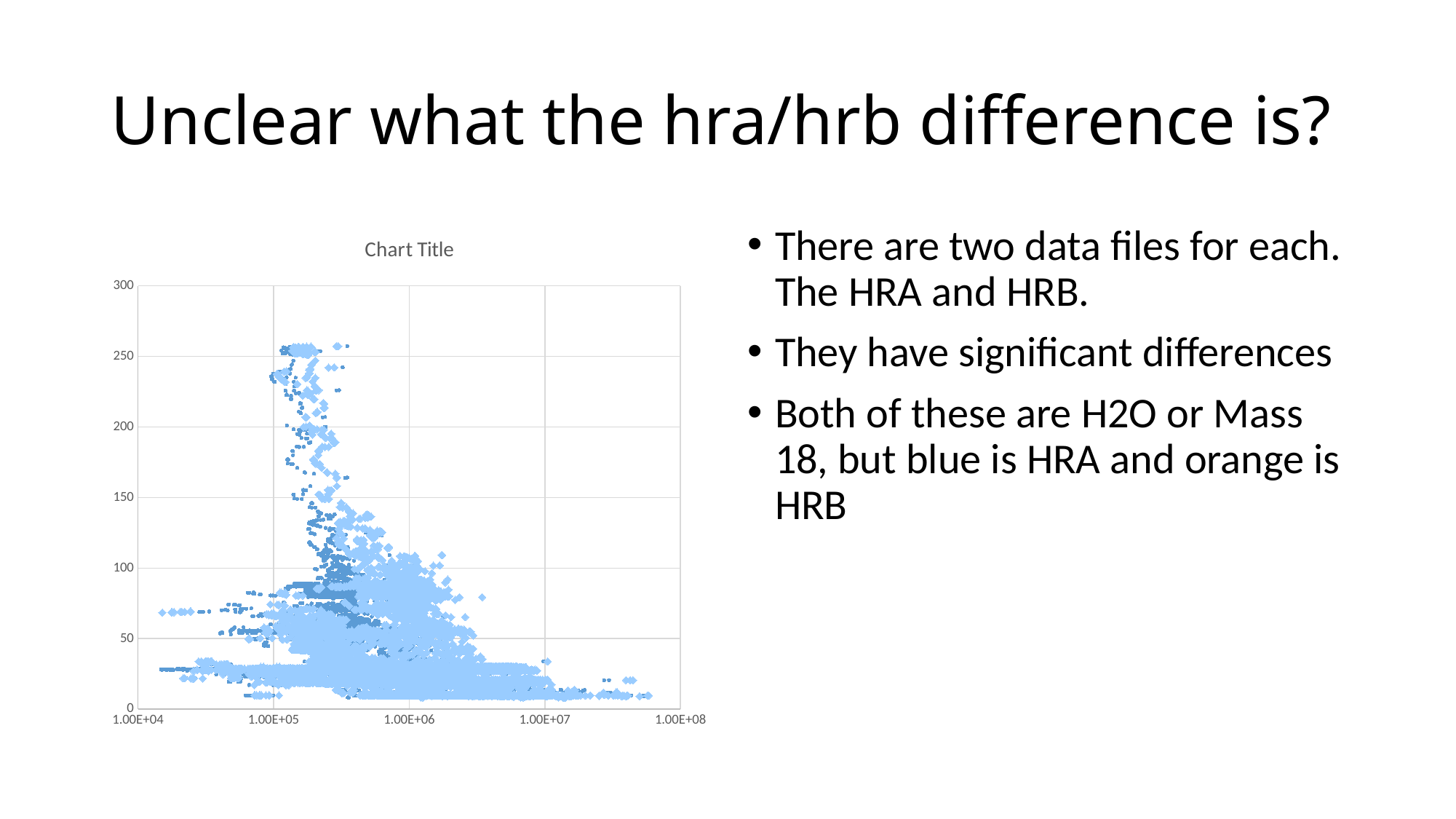
Is the lowest y value plotted on the chart greater or less than 50? less Is the highest y value plotted on the chart greater or less than 200? greater What kind of chart is shown on the slide? scatter chart Are the points near the right end of the x axis (around 1.00E+07 and beyond) greater or less than 50 on the y axis? less What are the lowest and highest tick labels on the chart's x axis? 1.00E+04 and 1.00E+08 Do the y values of the points generally rise or fall as x increases along the axis? fall What is the title shown above the chart? Chart Title